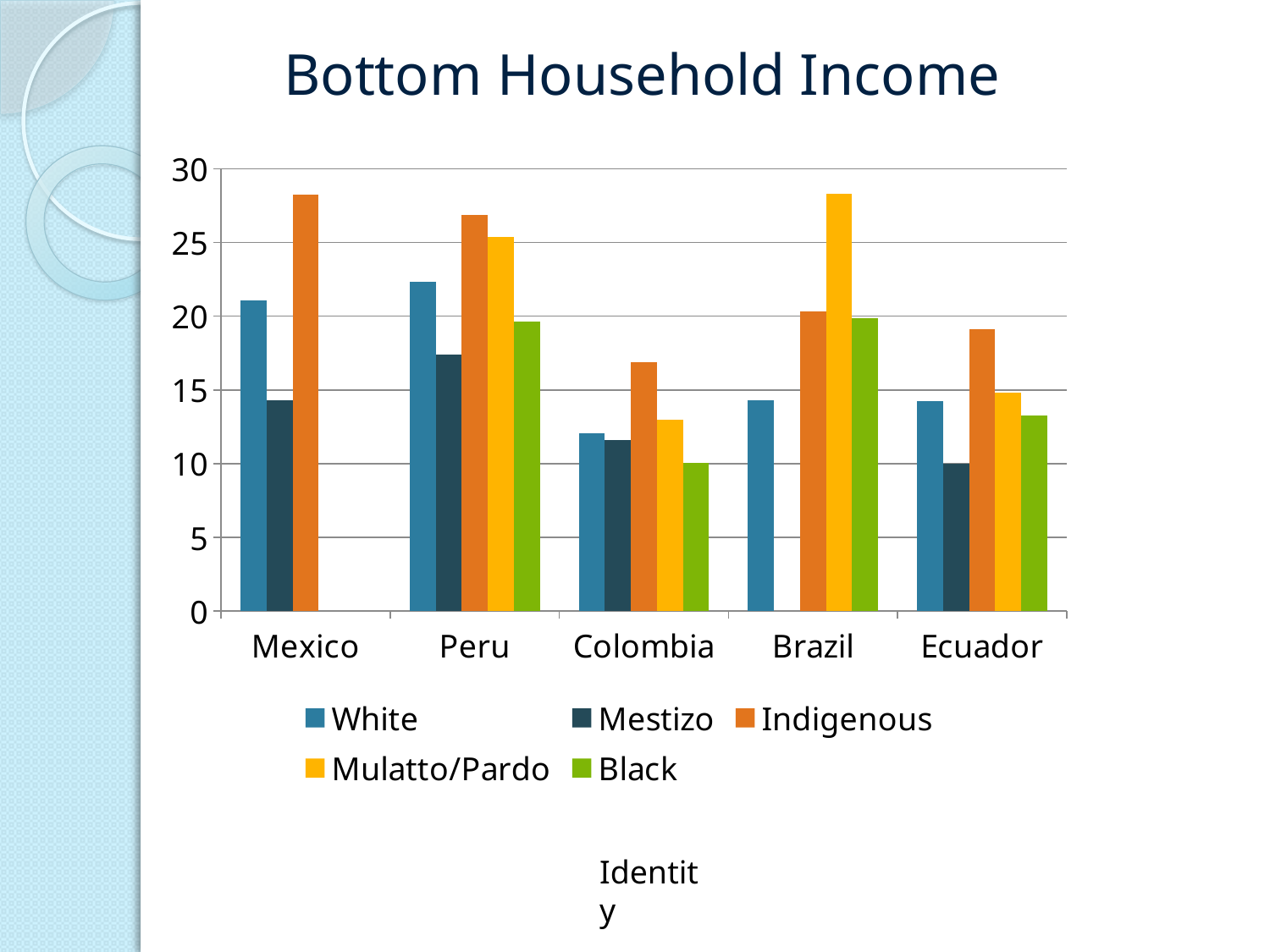
Which group has the highest value for Brazil? Mulatto/Pardo For Mexico, which is larger, the White value or the Mestizo value? White How many countries are shown on the x axis? 5 How many series does the legend list? 5 Which group has the lowest value for Colombia? Black Is the White value for Peru greater or less than 20? greater Is the Mestizo value for Peru greater or less than 20? less For Ecuador, which is larger, the Indigenous value or the Mulatto/Pardo value? Indigenous Which group has the highest value for Mexico? Indigenous Is the Indigenous value for Mexico greater or less than 25? greater What is the title of the chart? Bottom Household Income What kind of chart is shown on the slide? bar chart